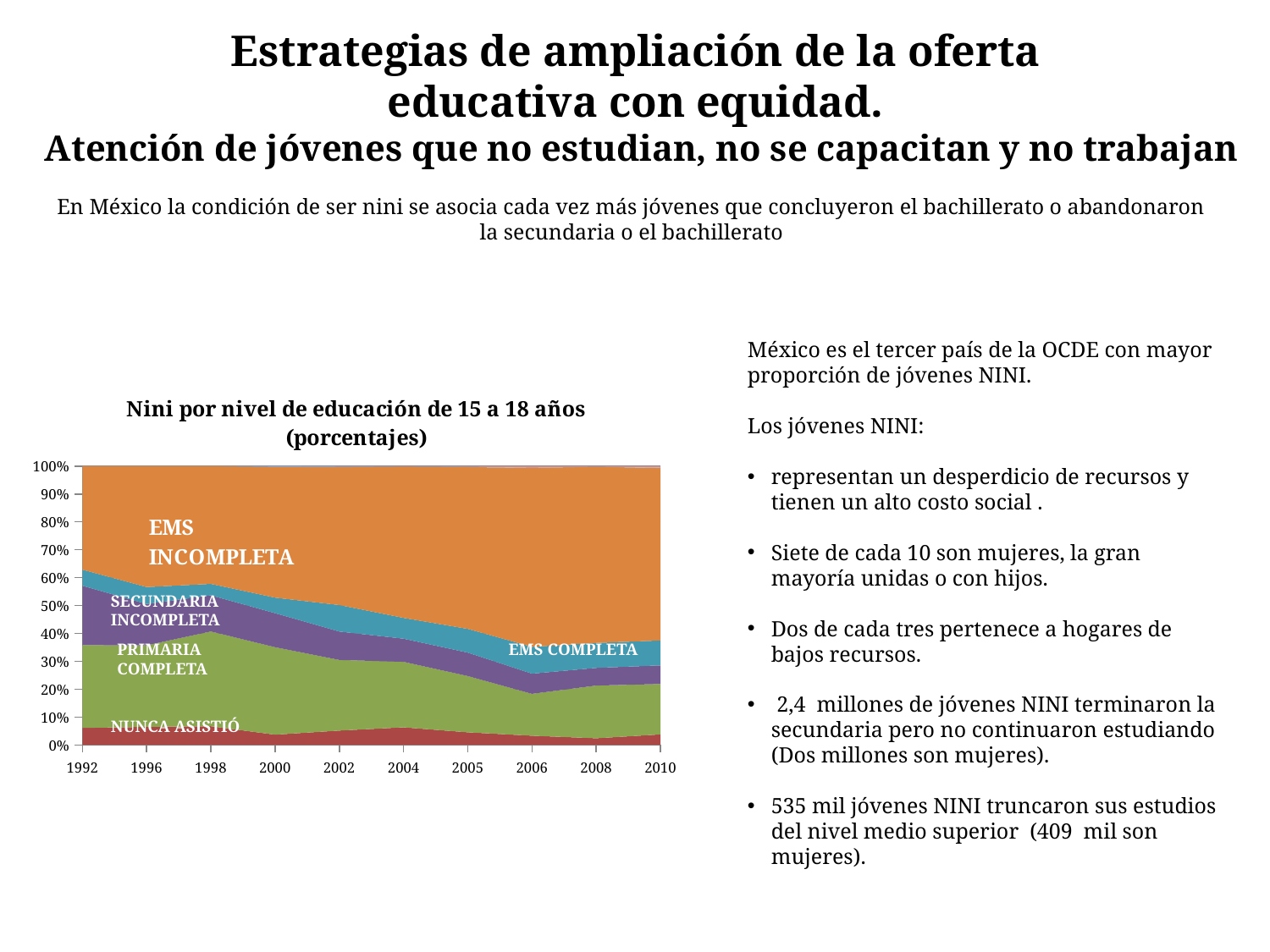
What kind of chart is shown under the title 'Nini por nivel de educación de 15 a 18 años (porcentajes)'? Stacked area chart What is the highest value shown on the y axis of the chart? 100% What is the last year shown on the x axis of the chart? 2010 Which education-level category occupies the smallest area of the chart? NUNCA ASISTIÓ How many education-level categories are labelled inside the chart area? 5 What is the title of the chart on the slide? Nini por nivel de educación de 15 a 18 años (porcentajes) Does the share for PRIMARIA COMPLETA rise or fall between 1998 and 2006? fall Does the share for EMS INCOMPLETA rise or fall between 1992 and 2006? rise How many years are marked along the x axis of the chart? 10 Which education-level category occupies the largest area of the chart? EMS INCOMPLETA Is the share for NUNCA ASISTIÓ in 1992 greater or less than 10%? less What is the first year shown on the x axis of the chart? 1992